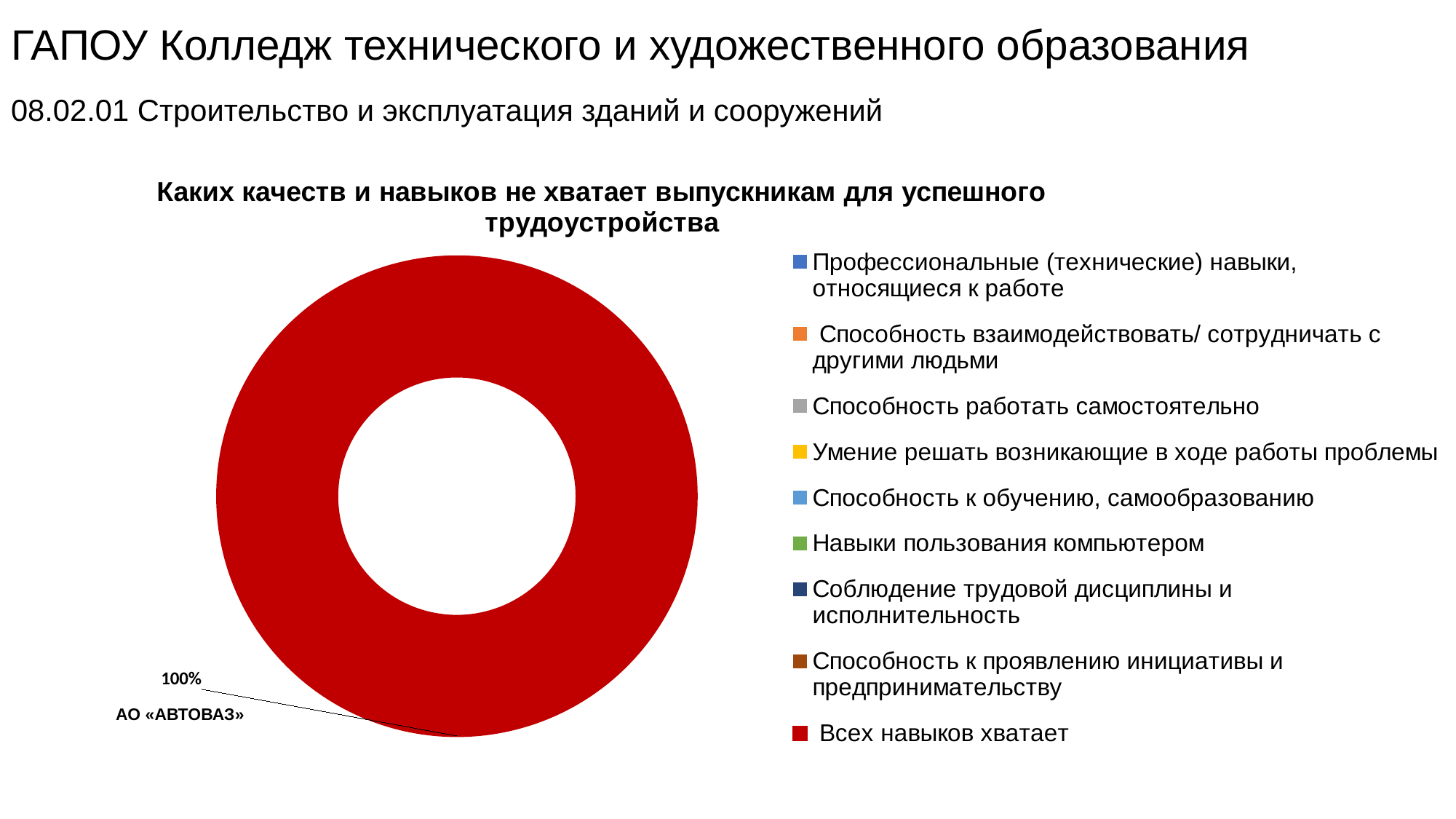
What value is printed as the data label on the chart? 100% Which legend category accounts for the entire chart? Всех навыков хватает Is the value for "Всех навыков хватает" greater or less than 50%? greater What is the title of the chart? Каких качеств и навыков не хватает выпускникам для успешного трудоустройства What kind of chart is shown on the slide? Doughnut (pie) chart Which is larger: the share for "Всех навыков хватает" or the share for "Навыки пользования компьютером"? Всех навыков хватает How many entries does the chart legend list? 9 How many slices are visibly plotted in the chart? 1 What share of the chart does the slice "Всех навыков хватает" take? 100% Which organisation is named in the data label next to the 100% slice? АО «АВТОВАЗ»